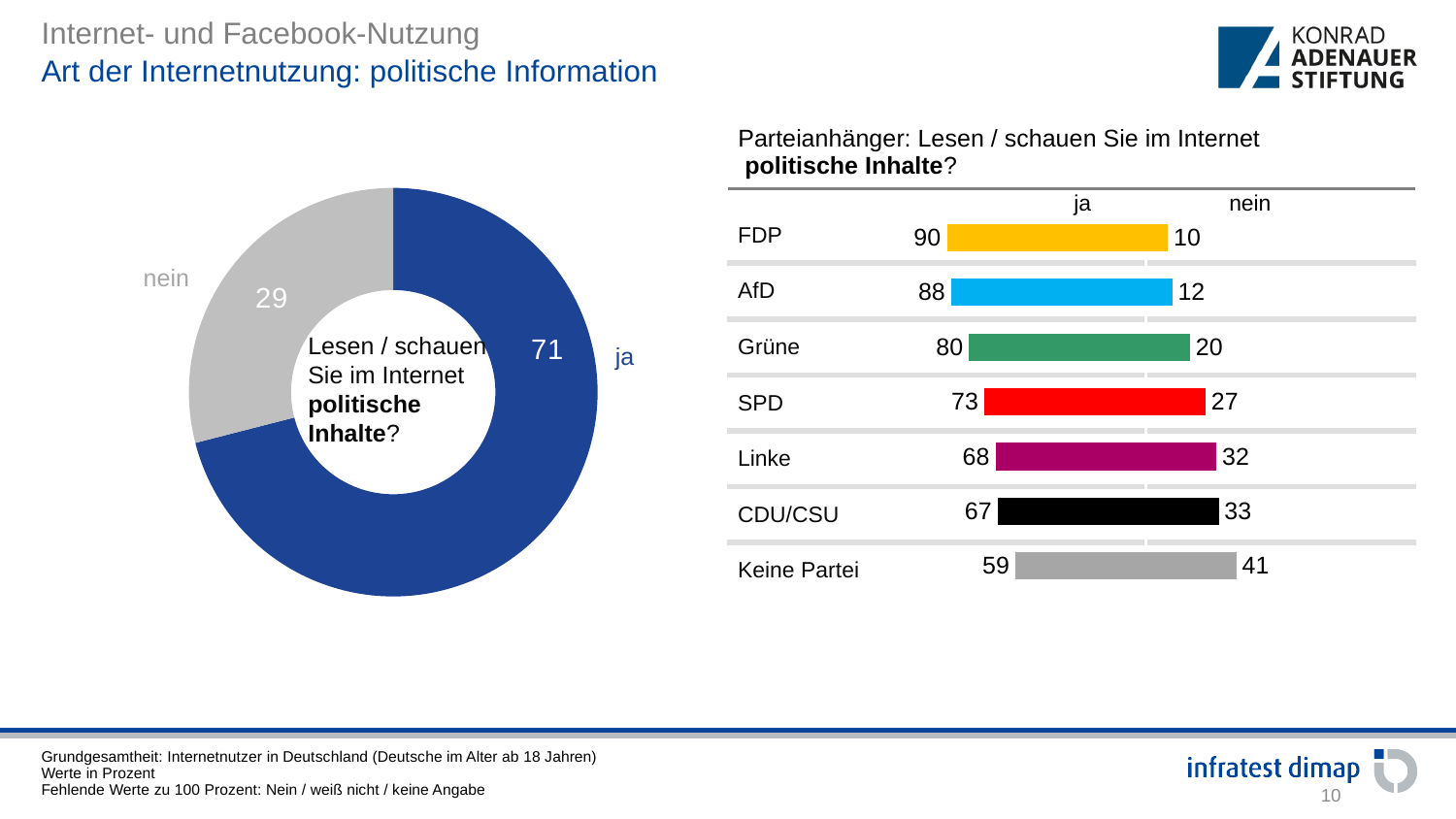
In the bar chart on the right (Parteianhänger), do the "ja" values rise or fall going down the list from FDP to Keine Partei? Fall In the donut chart on the left, what is the value for "nein"? 29 In the bar chart on the right (Parteianhänger), what is the "ja" value for FDP? 90 What kind of chart is shown on the left of the slide? Donut (pie) chart In the bar chart on the right (Parteianhänger), which has a larger "ja" value, AfD or Linke? AfD In the donut chart on the left, what is the value for "ja"? 71 In the bar chart on the right (Parteianhänger), what is the difference between the "ja" values for Grüne and CDU/CSU? 13 In the bar chart on the right (Parteianhänger), what is the "nein" value for SPD? 27 How many party categories are listed in the bar chart on the right (Parteianhänger)? 7 What kind of chart is shown on the right of the slide? Bar chart In the bar chart on the right (Parteianhänger), which category has the lowest "ja" value? Keine Partei In the bar chart on the right (Parteianhänger), which party has the highest "ja" value? FDP